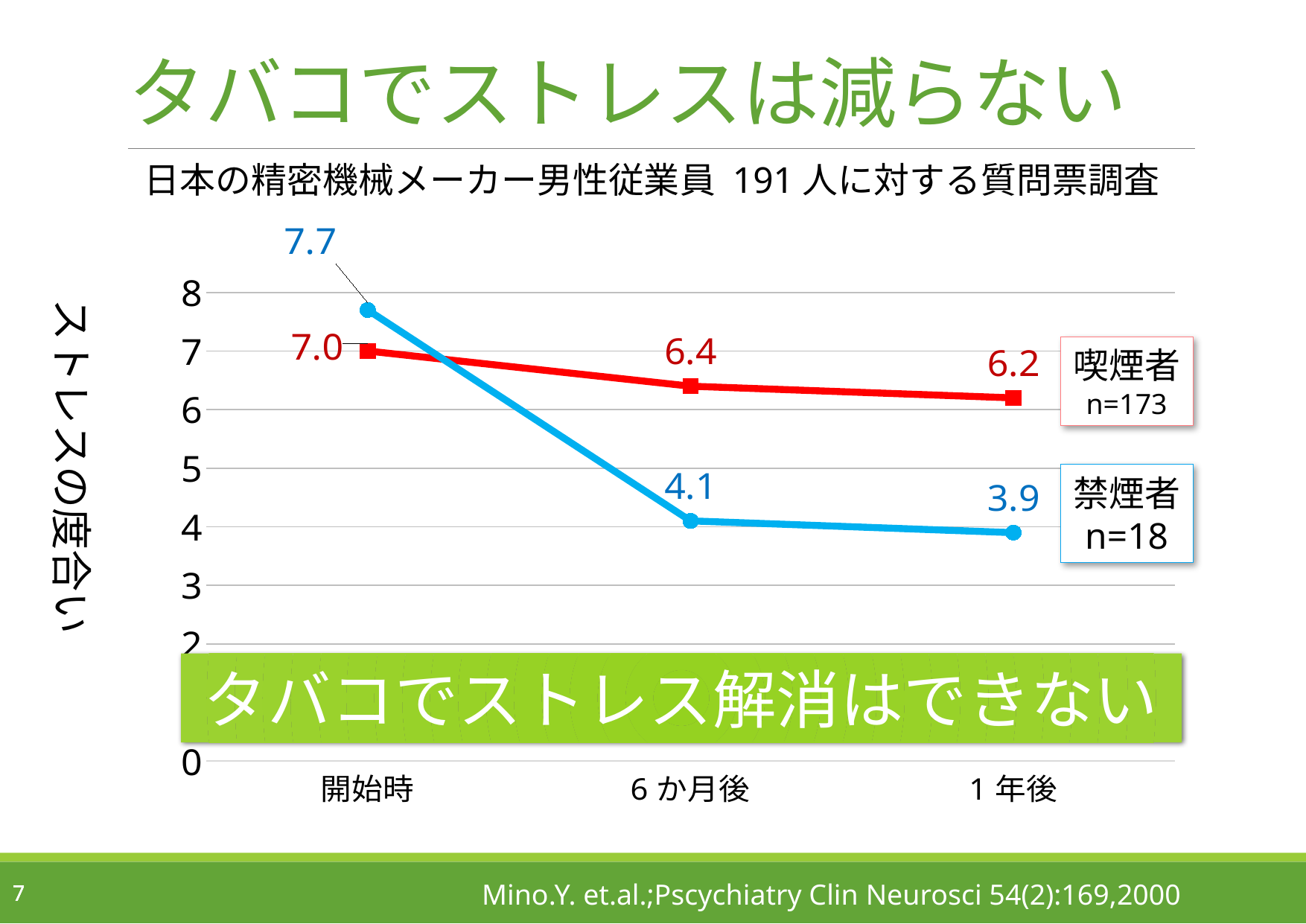
What is the stress level for 禁煙者 at 1年後? 3.9 How many time points are plotted on the x axis? 3 Does the stress level for 禁煙者 rise or fall from 開始時 to 1年後? fall What is the difference between the 禁煙者 stress level at 開始時 and at 1年後? 3.8 What is the stress level for 禁煙者 (quitters) at 6か月後? 4.1 At which time point is the stress level for 禁煙者 highest? 開始時 Which group has the higher stress level at 6か月後, 喫煙者 or 禁煙者? 喫煙者 What is the stress level for 喫煙者 (smokers) at 開始時? 7.0 What kind of chart is shown on the slide? line chart How many series are plotted in the chart? 2 What is the stress level for 喫煙者 at 1年後? 6.2 At which time point is the stress level for 喫煙者 lowest? 1年後